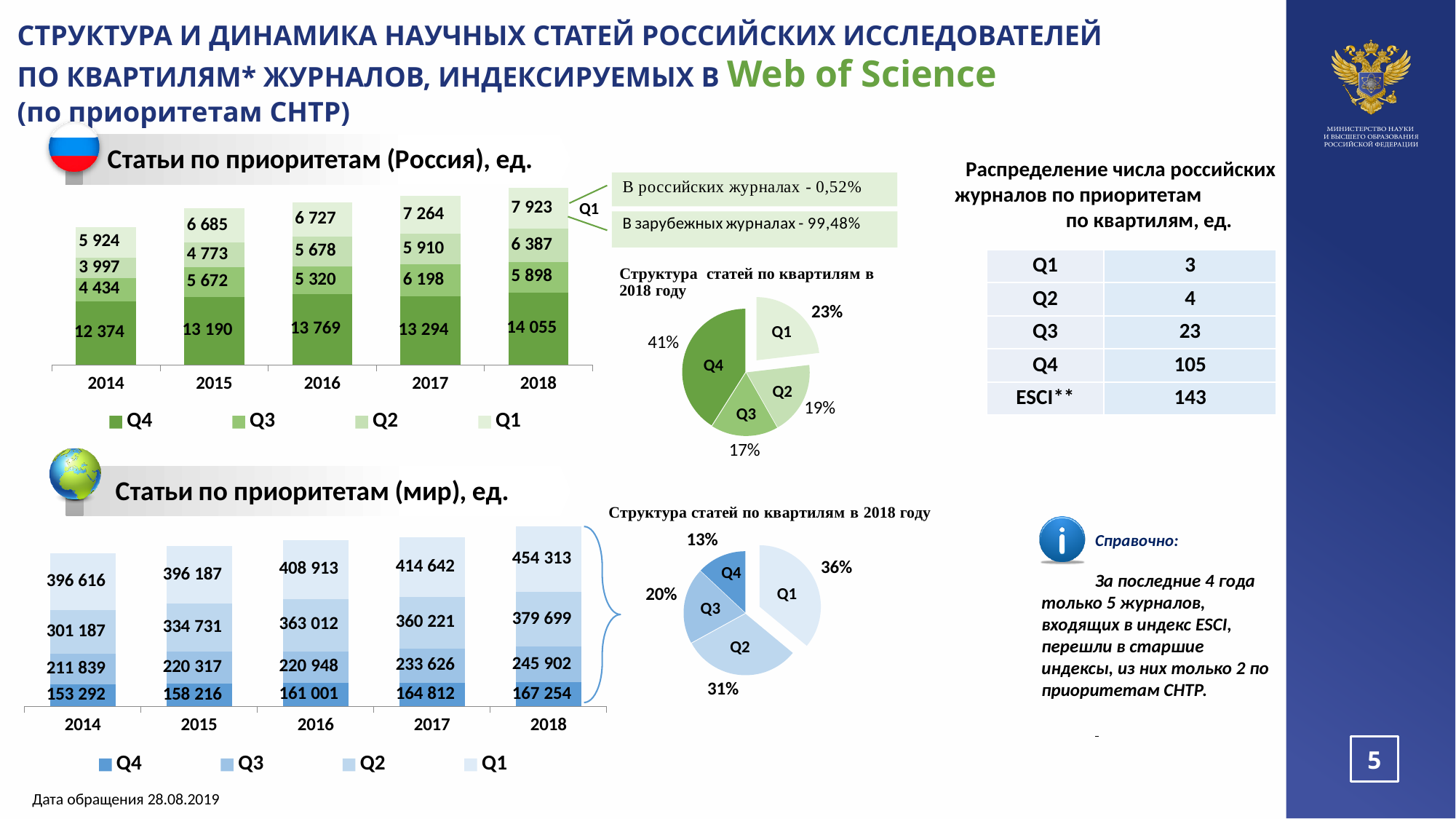
In the 'Статьи по приоритетам (Россия), ед.' chart, does the Q1 series rise or fall from 2014 to 2018? rise In the lower pie chart 'Структура статей по квартилям в 2018 году' (world), which quartile has the smallest share? Q4 In the 'Статьи по приоритетам (мир), ед.' chart, which year has the lowest Q4 value? 2014 In the upper pie chart 'Структура статей по квартилям в 2018 году' (Russia), what share does Q4 have? 41% In the 'Статьи по приоритетам (Россия), ед.' chart, what is the total of the stacked bar for 2018? 34 263 In the 'Статьи по приоритетам (Россия), ед.' chart, which year has the highest Q4 value? 2018 What kind of chart is 'Статьи по приоритетам (мир), ед.'? stacked bar chart In the 'Статьи по приоритетам (мир), ед.' chart, how many series does the legend list? 4 In the 'Статьи по приоритетам (Россия), ед.' chart, by how much does the Q4 value for 2018 exceed the Q4 value for 2014? 1 681 In the 'Статьи по приоритетам (мир), ед.' chart, what is the Q1 value for 2018? 454 313 In the 'Статьи по приоритетам (Россия), ед.' chart, what is the Q4 value for 2018? 14 055 In the 'Статьи по приоритетам (Россия), ед.' chart, what is the Q1 value for 2014? 5 924